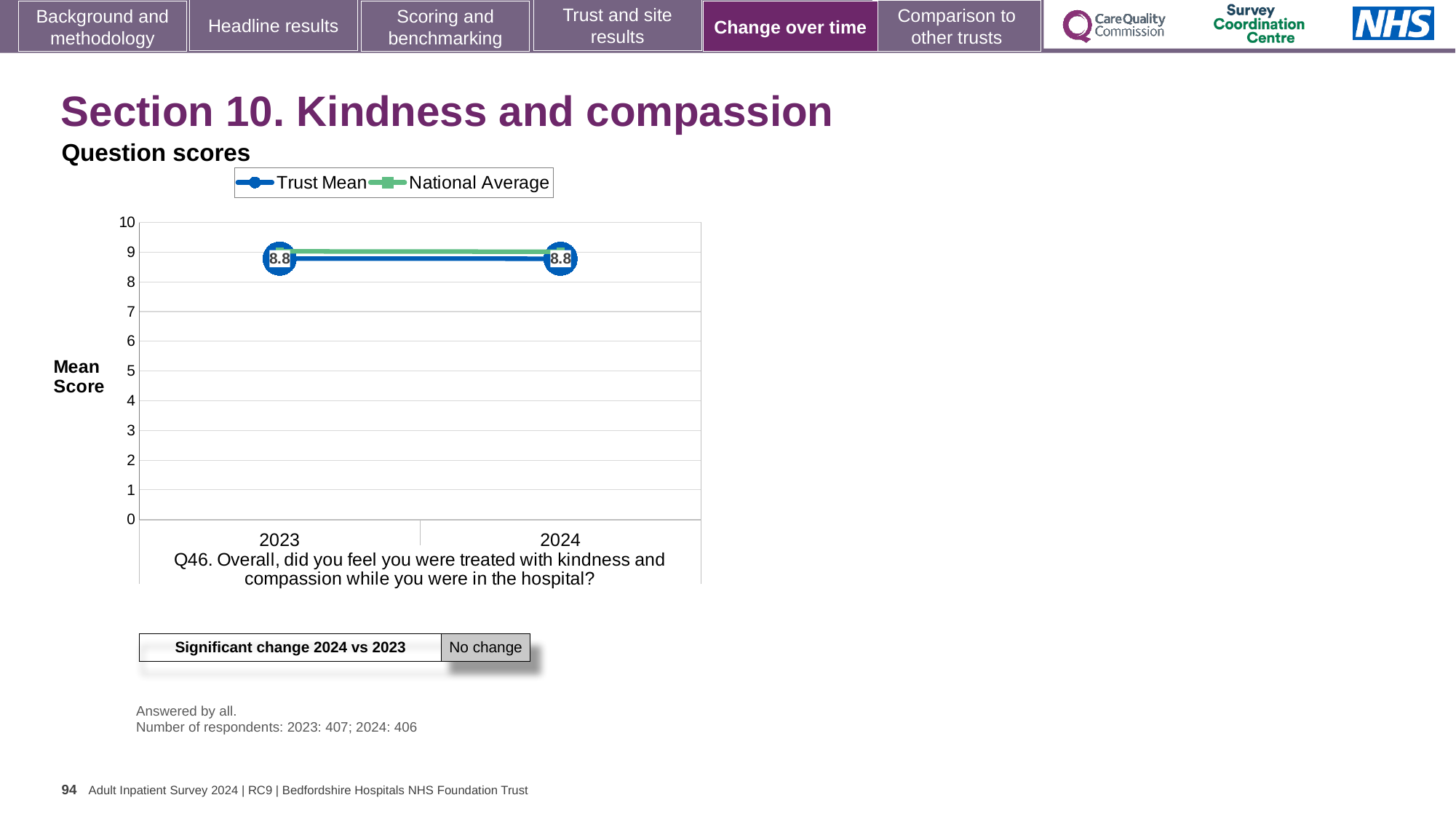
Is the National Average value for 2023 greater or less than 8? greater What is the label on the y axis of the chart? Mean Score How many years are plotted on the x axis of the chart? 2 Which series is shown in blue in the chart legend? Trust Mean How many series does the chart legend list? 2 What is the Trust Mean score for 2023? 8.8 What kind of chart is shown on the slide? Line chart What is the Trust Mean score for 2024? 8.8 Is the National Average value for 2024 greater or less than 10? less What is the difference between the Trust Mean score in 2024 and in 2023? 0 Does the Trust Mean rise, fall or stay the same from 2023 to 2024? Stays the same